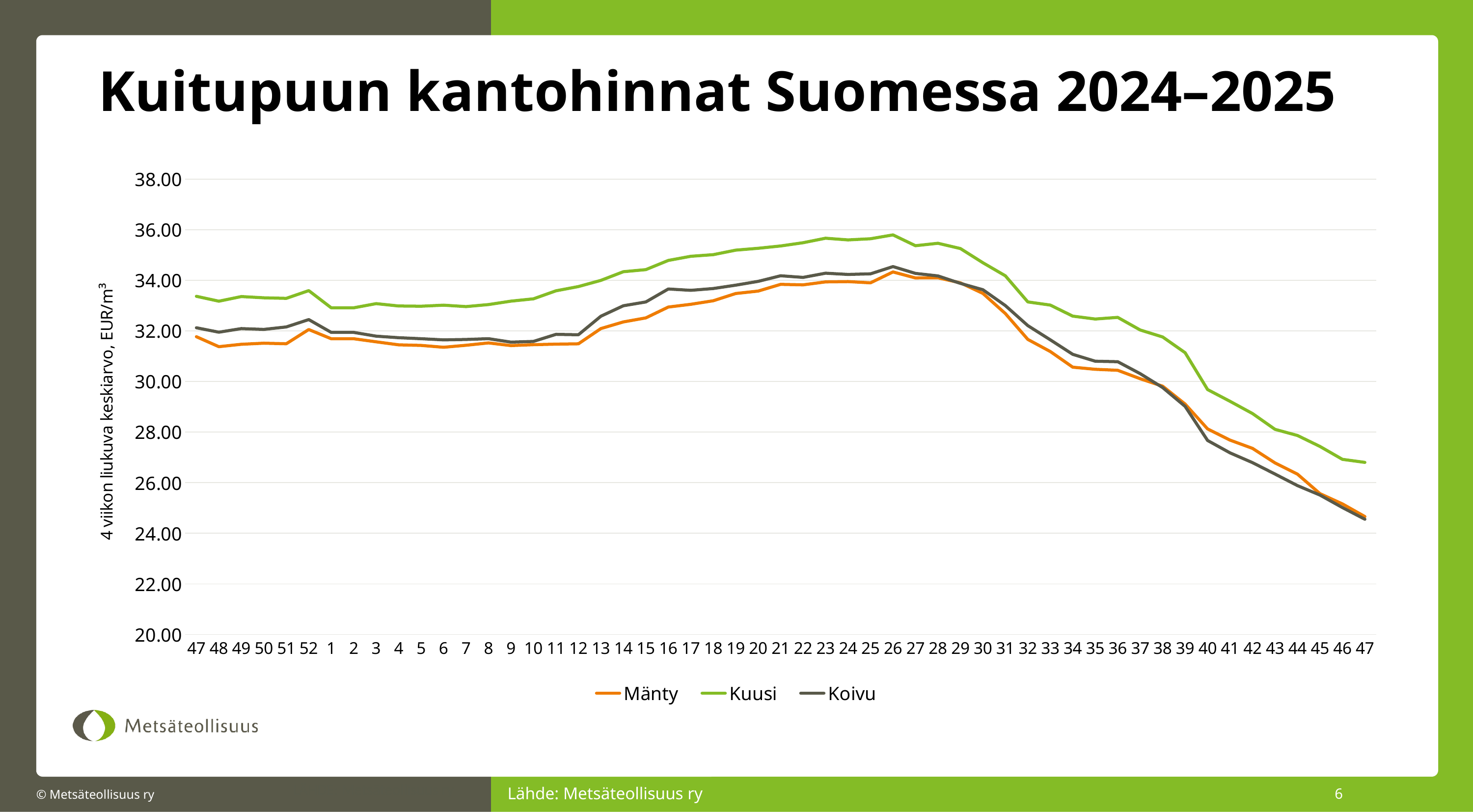
How many series does the legend list? 3 Is the value for Kuusi at week 26 greater or less than 34.00? greater Do the values for Mänty rise or fall from week 30 to week 47? fall Which series has the highest value at week 26? Kuusi Is the value for Kuusi at the final week 47 greater or less than 26.00? greater Which series has the lowest value at week 20? Mänty What is the title of the chart? Kuitupuun kantohinnat Suomessa 2024–2025 Is the value for Koivu at week 40 greater or less than 30.00? less What kind of chart is shown on the slide? line chart Which series are listed in the legend? Mänty, Kuusi, Koivu At week 10, which is larger, the value for Kuusi or the value for Mänty? Kuusi